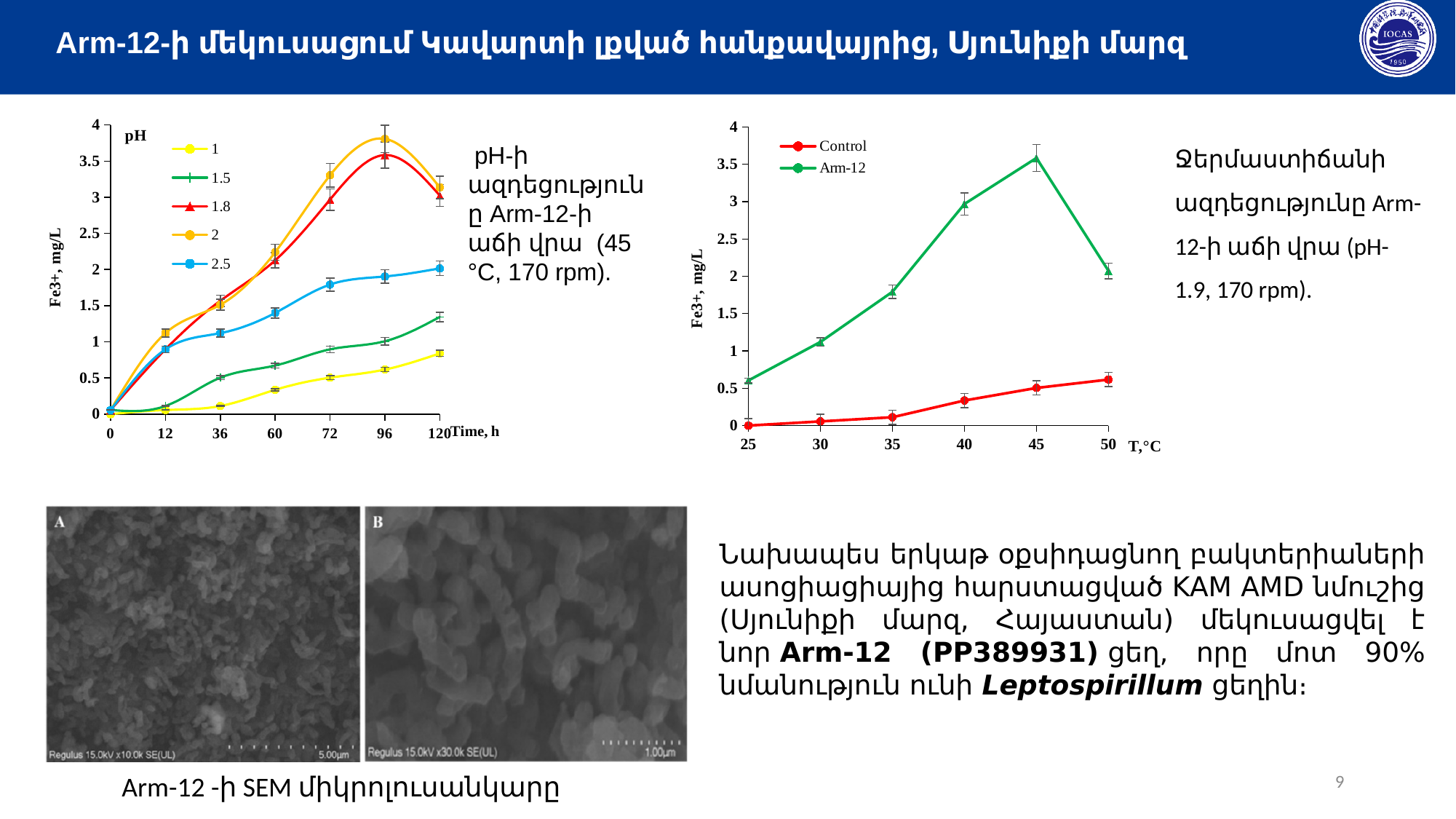
In the left chart, is the value for pH 2 at 96 h greater or less than 3.5? greater How many time points are marked on the x axis of the left chart? 7 In the right chart, does the Arm-12 series rise or fall between 45 °C and 50 °C? fall What kind of chart is the left chart (Fe3+ vs Time, h)? line chart In the left chart, at 72 h, which is larger: the value for pH 2.5 or the value for pH 1.5? pH 2.5 In the right chart, at which temperature does the Arm-12 series reach its highest value? 45 What is the y-axis label of the left chart? Fe3+, mg/L How many series does the legend of the left chart (pH) list? 5 In the left chart, which pH series has the lowest Fe3+ value at 120 h? 1 In the right chart, is the value for Control at 50 °C greater or less than 1? less How many series does the legend of the right chart (Fe3+ vs T, °C) list? 2 In the left chart, is the value for pH 1 at 120 h greater or less than 0.5? greater